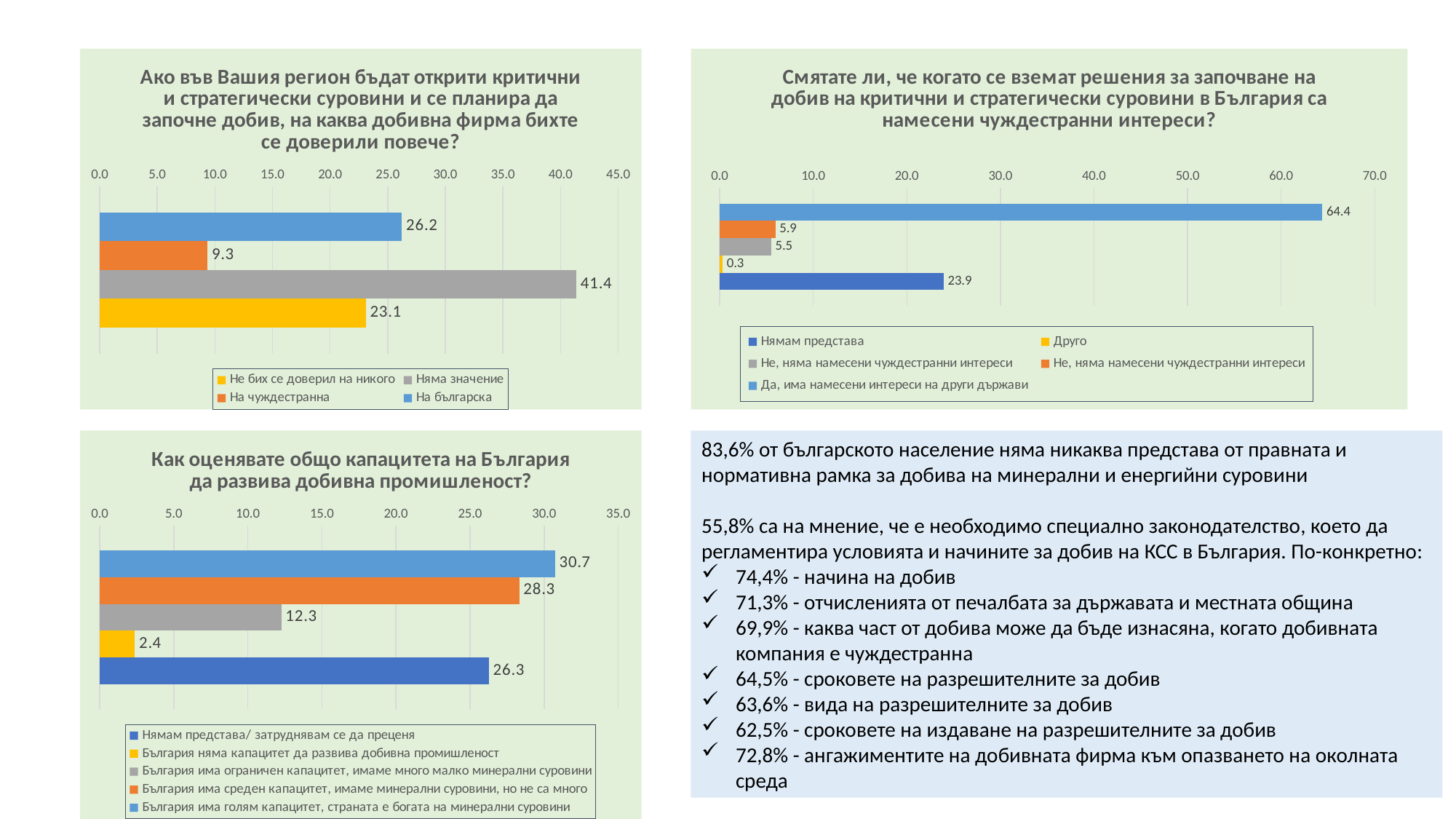
In the top-left chart, what is the value for 'Няма значение'? 41.4 In the bottom-left chart, which is larger: 'България има голям капацитет, страната е богата на минерални суровини' or 'Нямам представа/ затруднявам се да преценя'? България има голям капацитет, страната е богата на минерални суровини In the bottom-left chart, what is the difference between 'България има среден капацитет, имаме минерални суровини, но не са много' and 'България има ограничен капацитет, имаме много малко минерални суровини'? 16.0 In the top-left chart, which category has the lowest value? На чуждестранна In the top-left chart, what is the difference between 'На българска' and 'На чуждестранна'? 16.9 In the top-right chart, what is the value for 'Да, има намесени интереси на други държави'? 64.4 In the top-right chart, which category has the lowest value? Друго What type of chart is the bottom-left chart? Bar chart How many bars are plotted in the top-right chart? 5 In the top-right chart, what is the value for 'Нямам представа'? 23.9 In the bottom-left chart, what is the value for 'България няма капацитет да развива добивна промишленост'? 2.4 How many entries does the legend of the top-left chart list? 4